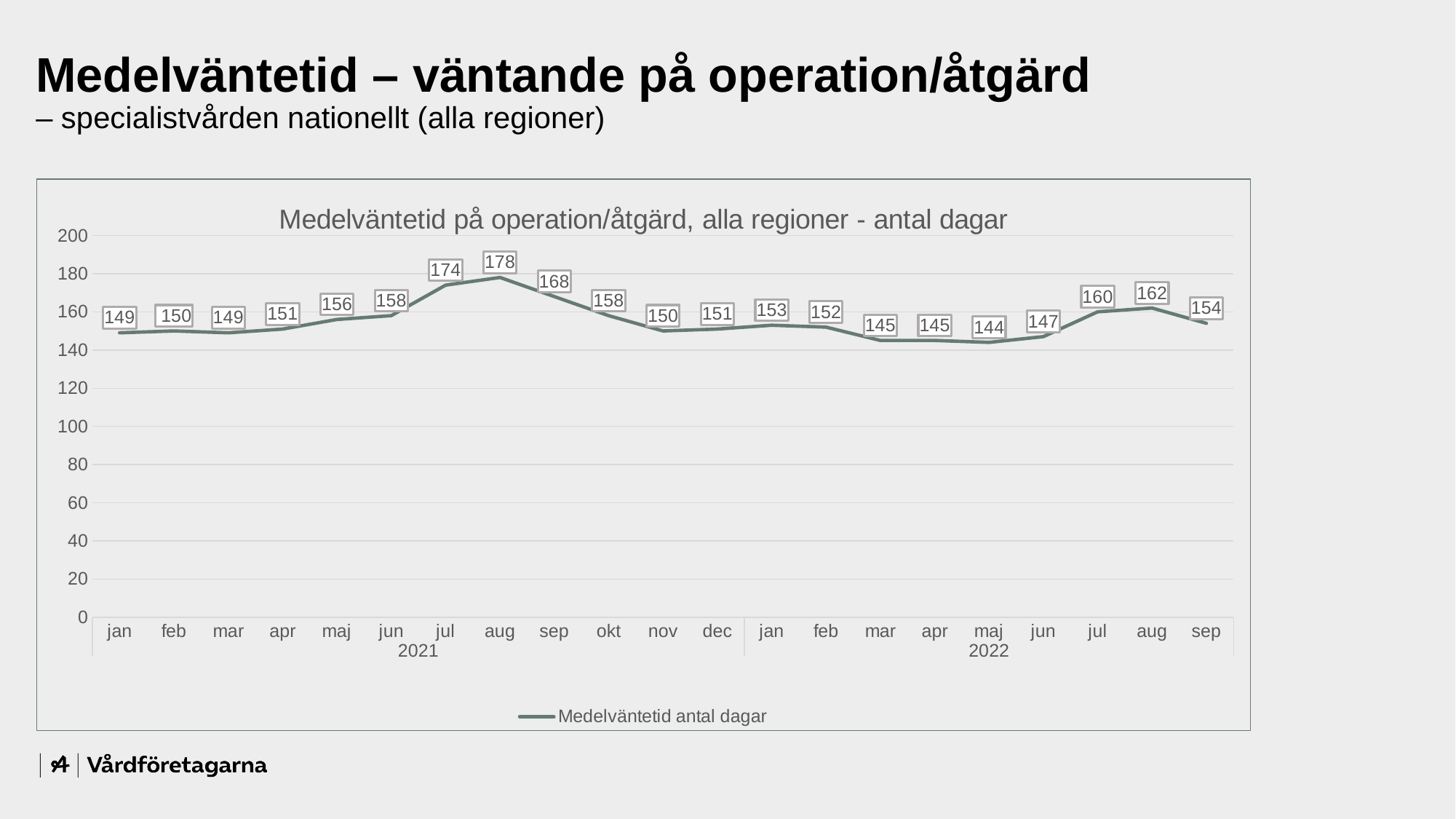
What type of chart is shown on the slide? Line chart What is the title of the chart? Medelväntetid på operation/åtgärd, alla regioner - antal dagar What is the value for maj 2022? 144 Is the value for aug 2021 greater or less than 160? greater Which is larger, the value for jul 2021 or the value for jul 2022? jul 2021 Which month has the highest value? aug 2021 What is the value for sep 2022? 154 What is the difference between the values for aug 2021 and maj 2022? 34 How many series does the legend list? 1 Which month has the lowest value? maj 2022 How many data points are plotted on the chart? 21 What is the value for aug 2021? 178